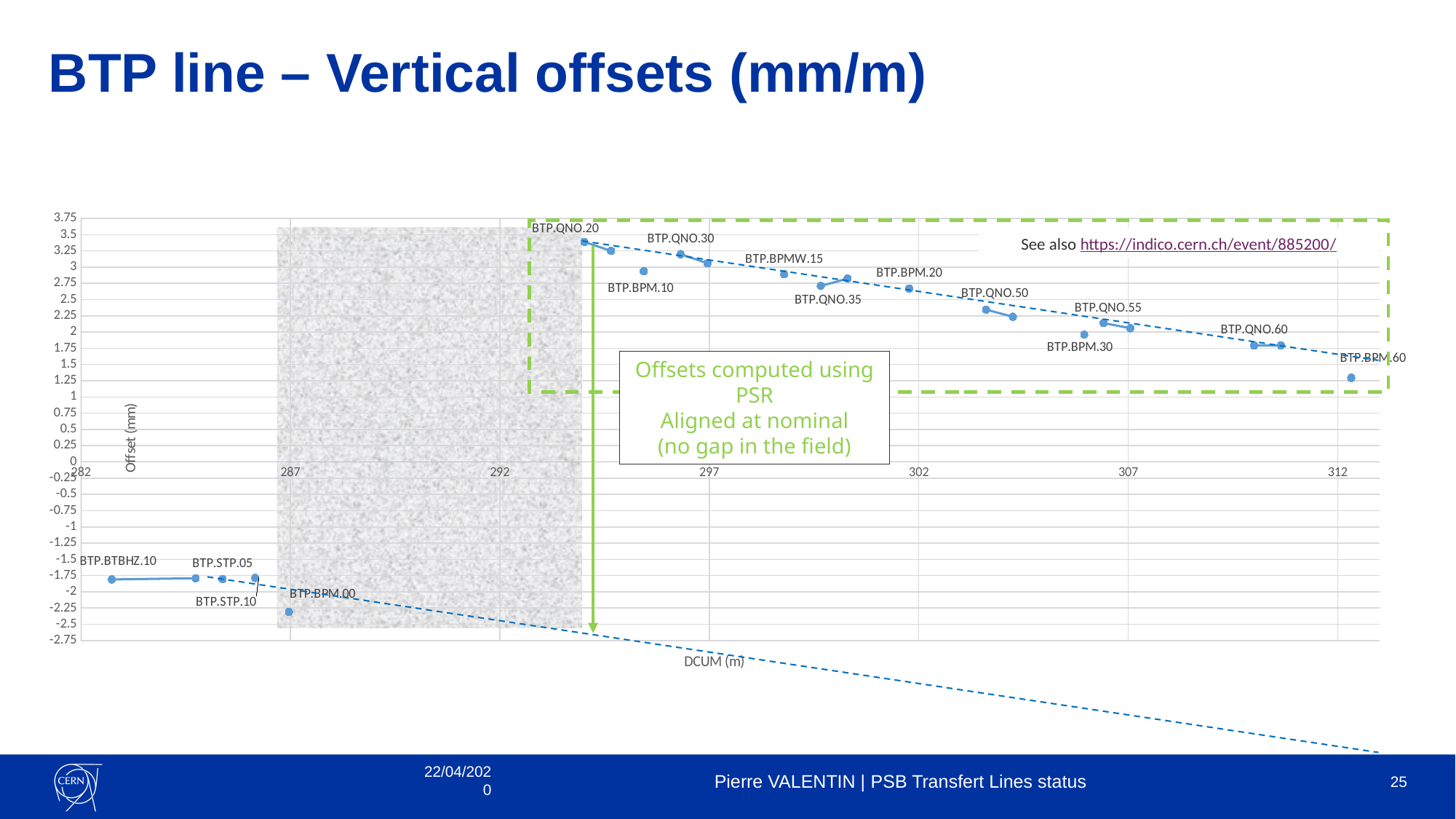
What is the title of the y axis of the chart? Offset (mm) Is the offset value for BTP.BPM.30 greater or less than 2.5? less Is the offset value for BTP.BPM.00 greater or less than -2? less Is the offset value for BTP.BPM.60 greater or less than 1.5? less Which labelled element has the lowest offset value on the chart? BTP.BPM.00 What kind of chart is shown on the slide? scatter chart Which has the larger offset value, BTP.QNO.20 or BTP.BPM.60? BTP.QNO.20 What is the title of the x axis of the chart? DCUM (m) Which has the larger offset value, BTP.BPM.00 or BTP.BTBHZ.10? BTP.BTBHZ.10 Do the offset values rise or fall along the x axis from BTP.QNO.20 to BTP.BPM.60? fall